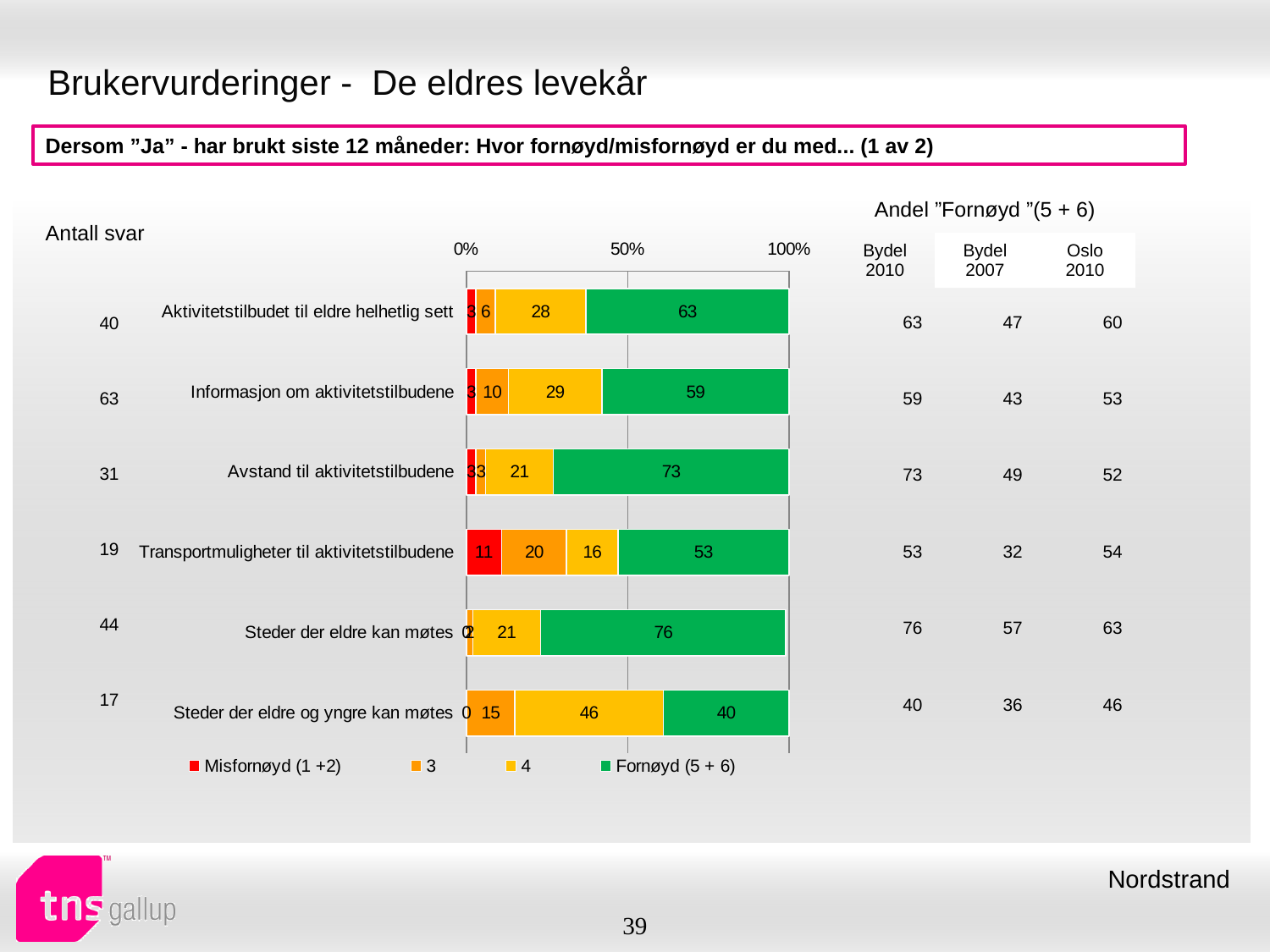
Which category has the highest Misfornøyd (1 +2) value? Transportmuligheter til aktivitetstilbudene What is the Fornøyd (5 + 6) value for Transportmuligheter til aktivitetstilbudene? 53 How many series does the legend list? 4 What kind of chart is shown on the slide? Stacked bar chart What is the Misfornøyd (1 +2) value for Transportmuligheter til aktivitetstilbudene? 11 Which category has the highest Fornøyd (5 + 6) value? Steder der eldre kan møtes How many categories are shown in the chart? 6 What is the difference between the Fornøyd (5 + 6) values for Avstand til aktivitetstilbudene and Informasjon om aktivitetstilbudene? 14 Which has a larger Fornøyd (5 + 6) value: Aktivitetstilbudet til eldre helhetlig sett or Steder der eldre og yngre kan møtes? Aktivitetstilbudet til eldre helhetlig sett What is the Fornøyd (5 + 6) value for Steder der eldre kan møtes? 76 What is the value of series 4 for Steder der eldre og yngre kan møtes? 46 Which category has the lowest Fornøyd (5 + 6) value? Steder der eldre og yngre kan møtes